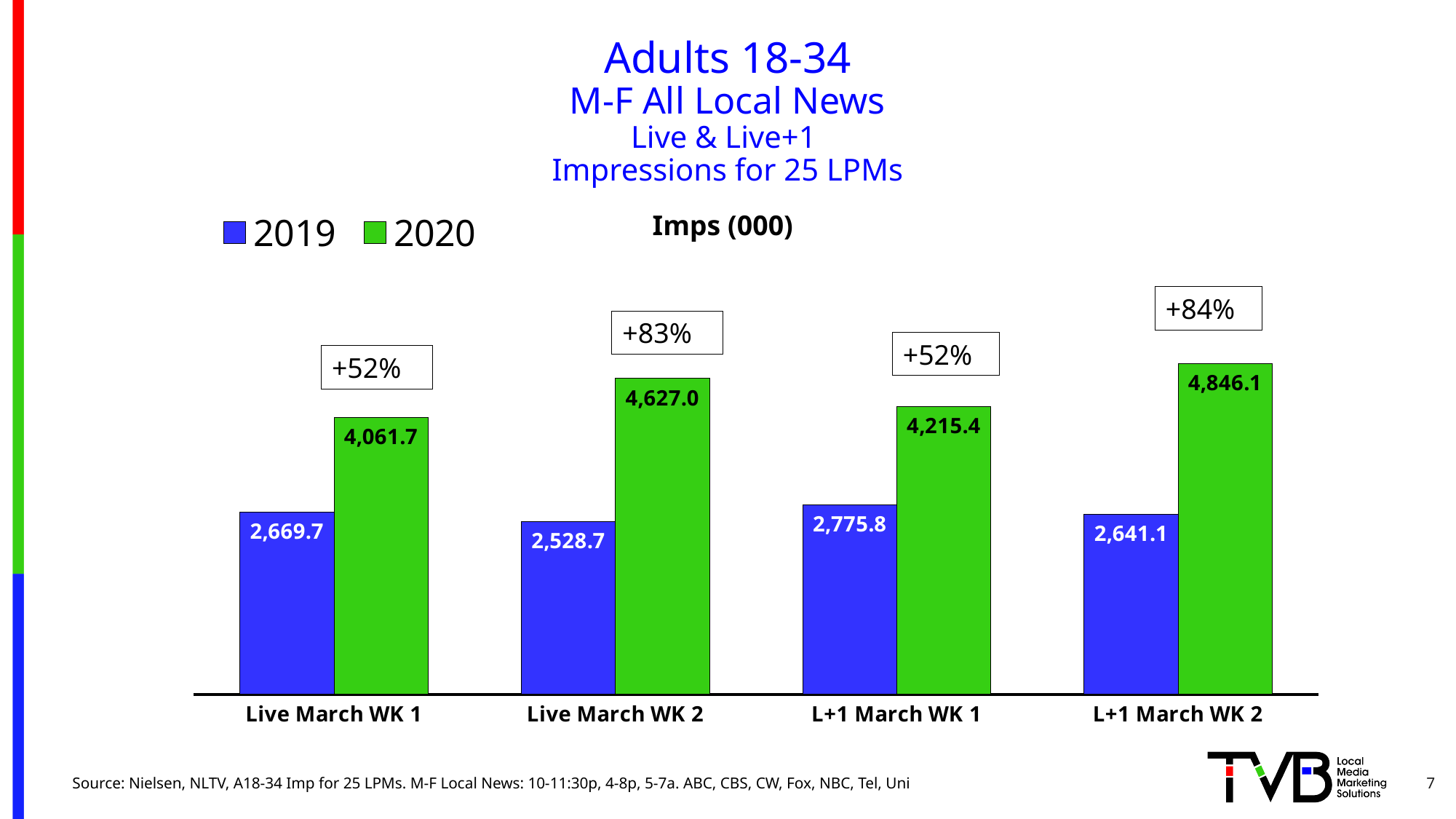
Which is larger, the 2019 value for L+1 March WK 1 or the 2019 value for Live March WK 1? L+1 March WK 1 What is the 2020 value for L+1 March WK 2? 4,846.1 How many categories are shown on the x axis? 4 What percentage change is shown above the L+1 March WK 2 bars? +84% How many series does the legend list? 2 What is the 2020 value for Live March WK 2? 4,627.0 What is the 2019 value for L+1 March WK 1? 2,775.8 What is the difference between the 2020 and 2019 values for Live March WK 1? 1,392.0 Which category has the lowest 2019 value? Live March WK 2 Which colour represents the 2020 series in the legend? green What kind of chart is shown on the slide? bar chart Which category has the highest 2020 value? L+1 March WK 2